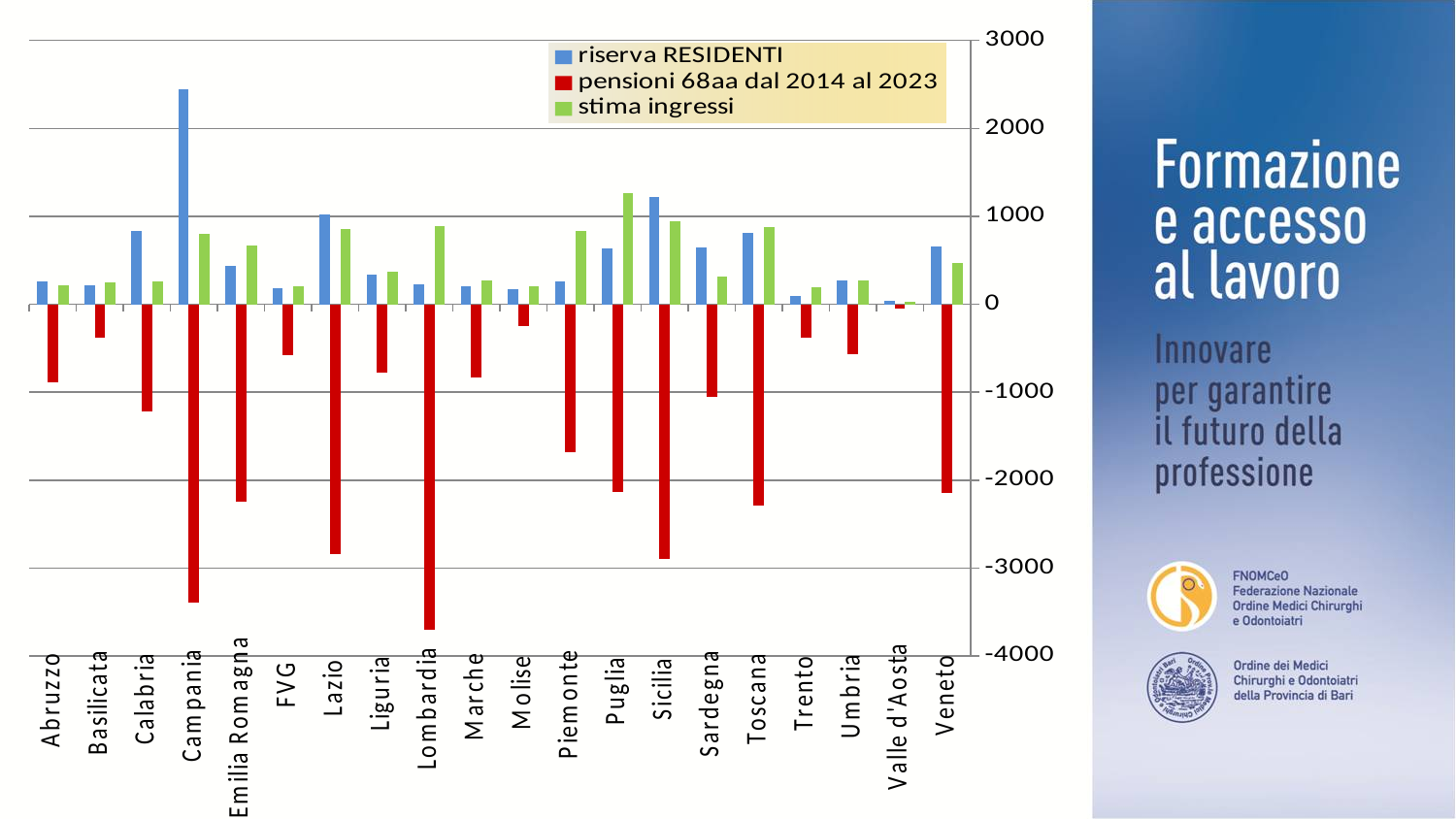
How many series does the chart legend list? 3 Which region has the larger riserva RESIDENTI value, Campania or Sicilia? Campania What kind of chart is shown on the slide? bar chart Which region has the lowest (most negative) value for pensioni 68aa dal 2014 al 2023? Lombardia What colour represents the stima ingressi series in the chart? green Is the pensioni 68aa dal 2014 al 2023 value for Lombardia greater or less than -3000? less Is the stima ingressi value for Puglia greater or less than 1000? greater Which region has the highest value for riserva RESIDENTI? Campania Which region has the larger stima ingressi value, Puglia or Sardegna? Puglia Which region has the highest value for stima ingressi? Puglia How many regions are shown along the x axis of the chart? 20 Is the riserva RESIDENTI value for Campania greater or less than 2000? greater